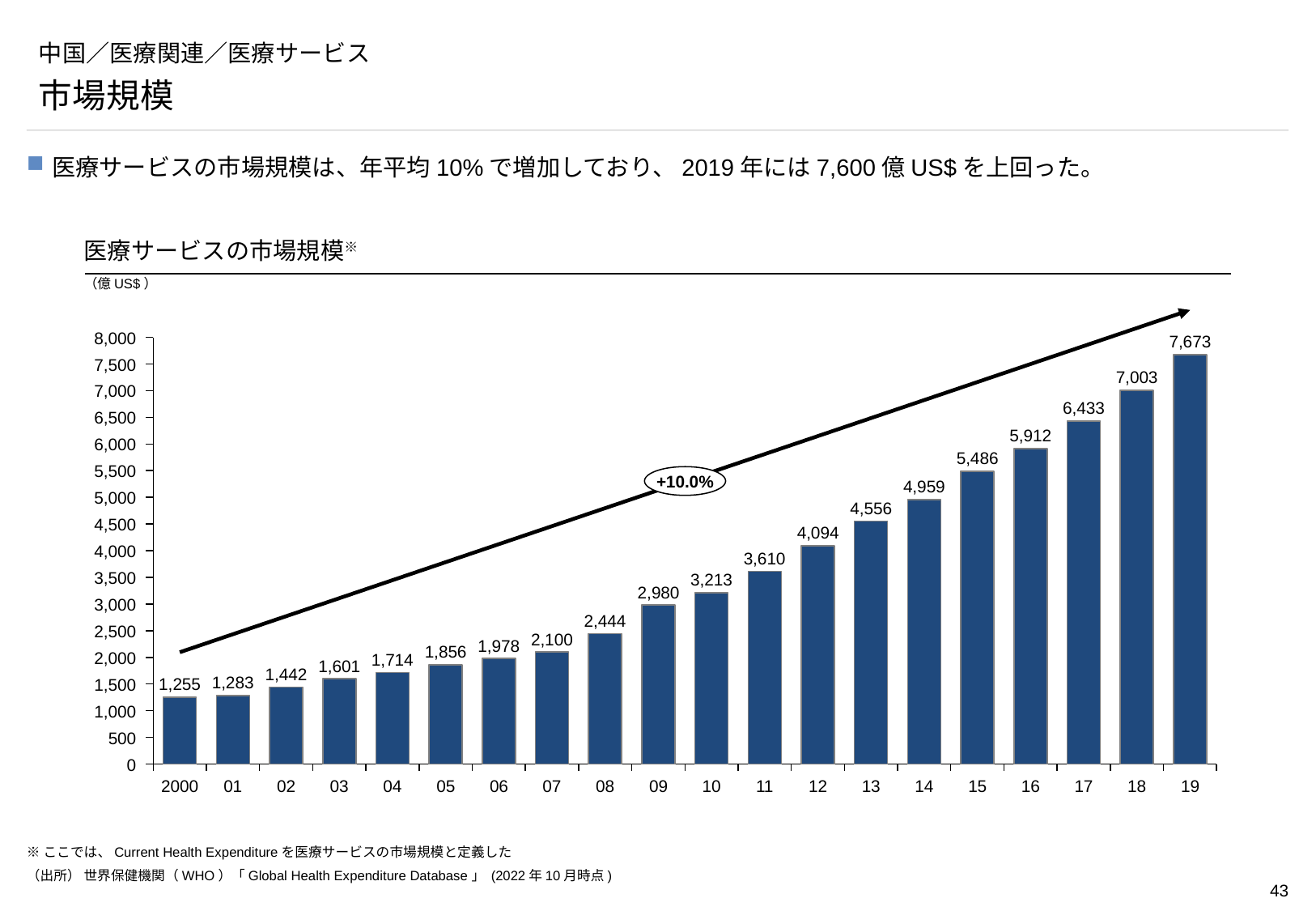
How many years are plotted on the chart? 20 Do the values rise or fall from 2000 to 2019? Rise Which year has the lowest value? 2000 What kind of chart is this? Bar chart What annual growth rate is shown in the label on the arrow? +10.0% What is the value for 2019? 7,673 What unit is shown for the chart's values? 億 US$ What is the value for 2010? 3,213 Which is larger, the value for 2012 or the value for 2013? 2013 What is the difference between the values for 2019 and 2018? 670 What is the value for 2000? 1,255 Which year has the highest value? 2019